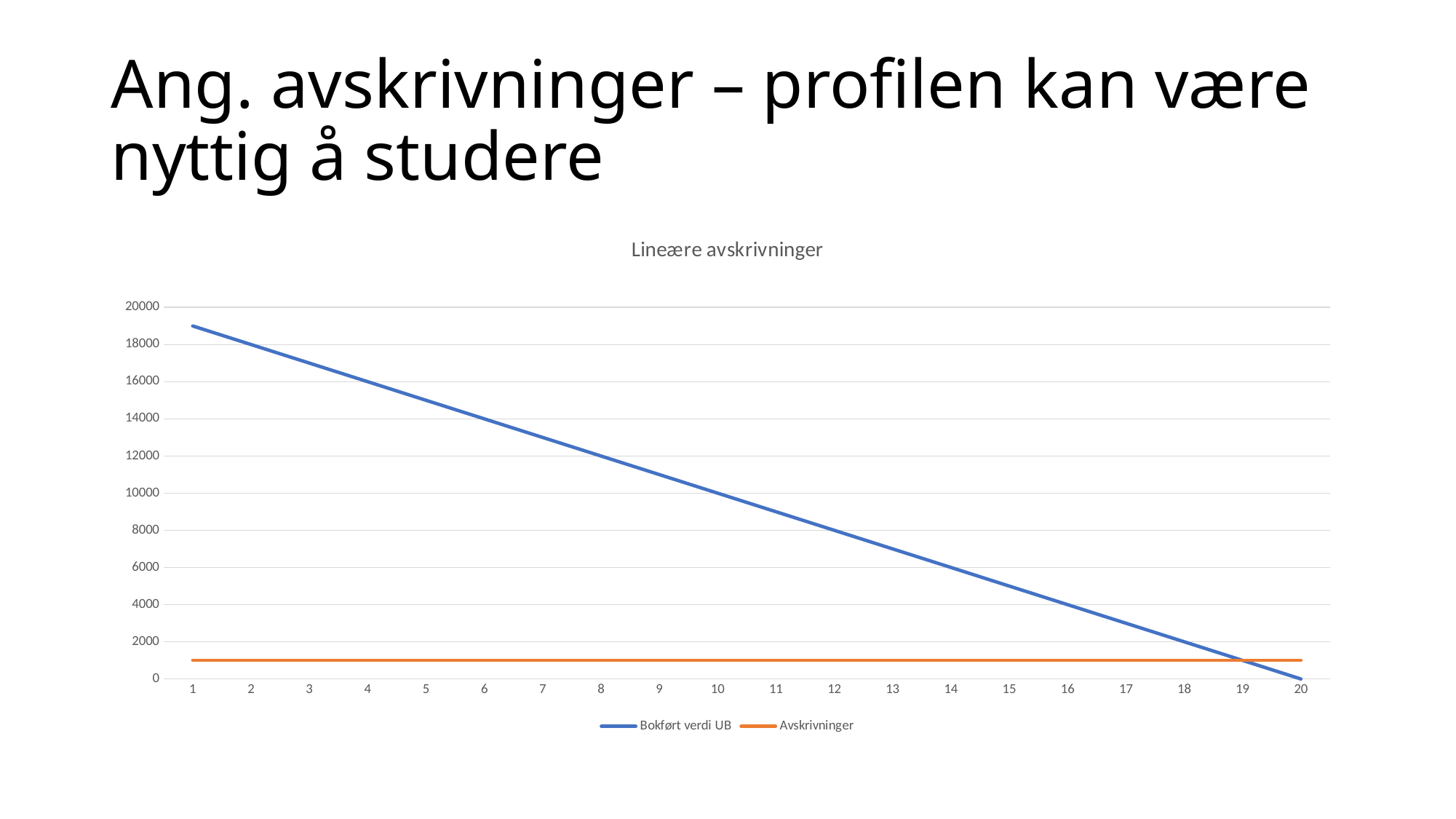
How many series does the legend list? 2 At which x value is Bokført verdi UB lowest? 20 Is the value for Bokført verdi UB at x = 5 greater or less than 14000? greater At x = 5, which series has the larger value, Bokført verdi UB or Avskrivninger? Bokført verdi UB Is the value for Avskrivninger at x = 10 greater or less than 2000? less Does the Bokført verdi UB series rise or fall along the x axis? fall What kind of chart is shown on the slide? line chart Is the value for Bokført verdi UB at x = 15 greater or less than 6000? less What is the value of Bokført verdi UB at x = 20? 0 At which x value is Bokført verdi UB highest? 1 How many points are plotted along the x axis for each series? 20 What is the title of the chart? Lineære avskrivninger